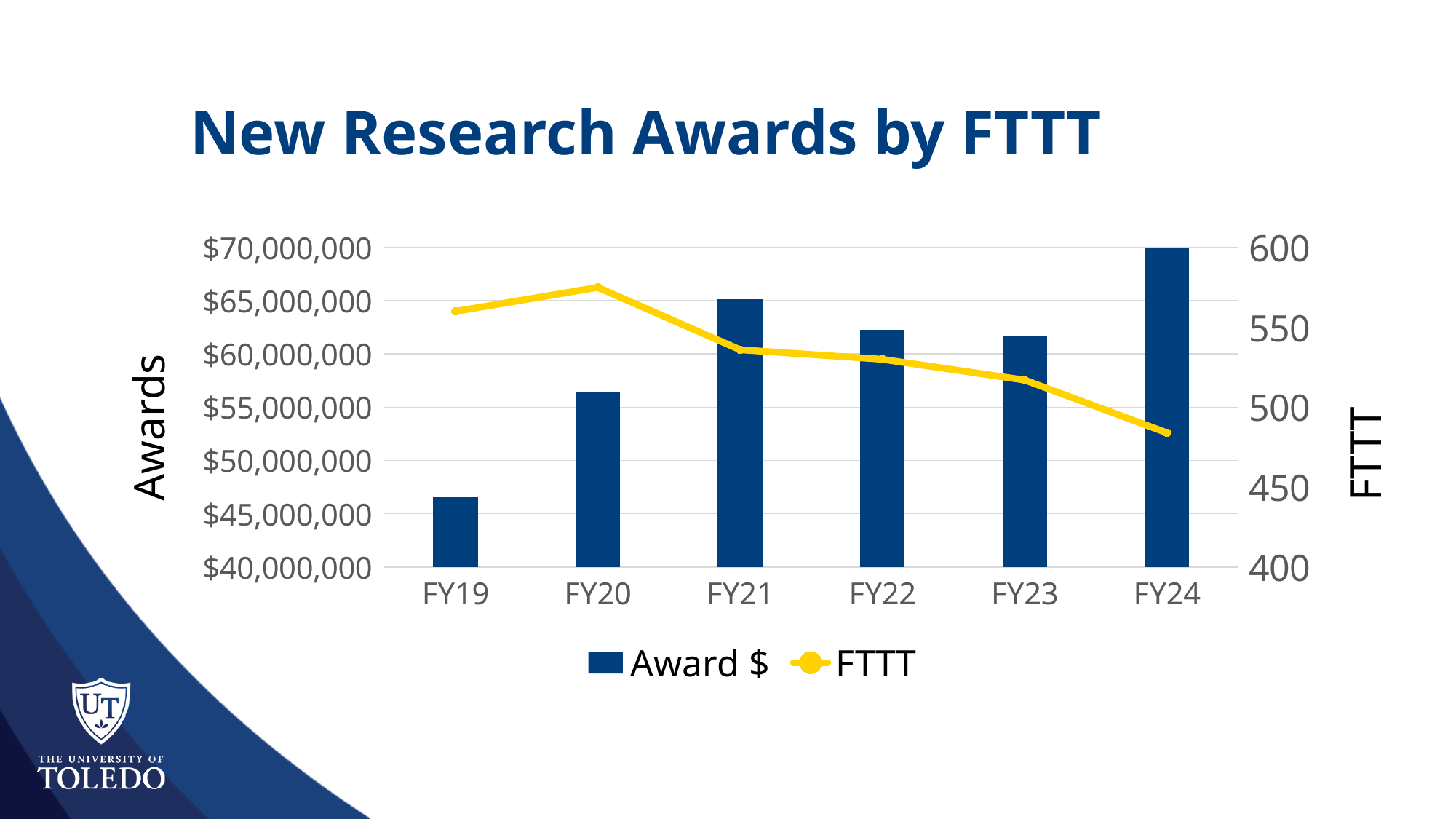
Is the FTTT value for FY24 greater or less than 500? less Which has the larger Award $ value, FY21 or FY22? FY21 Is the Award $ value for FY19 greater or less than $50,000,000? less What kind of chart is shown on the slide? A combination bar and line chart Does the FTTT line generally rise or fall from FY20 to FY24? fall Which fiscal year has the lowest FTTT value? FY24 How many series does the legend list? 2 How many fiscal years are shown on the x axis? 6 Which fiscal year has the highest Award $ bar? FY24 Which fiscal year has the lowest Award $ bar? FY19 What is the title of the chart? New Research Awards by FTTT Which fiscal year has the highest FTTT value? FY20